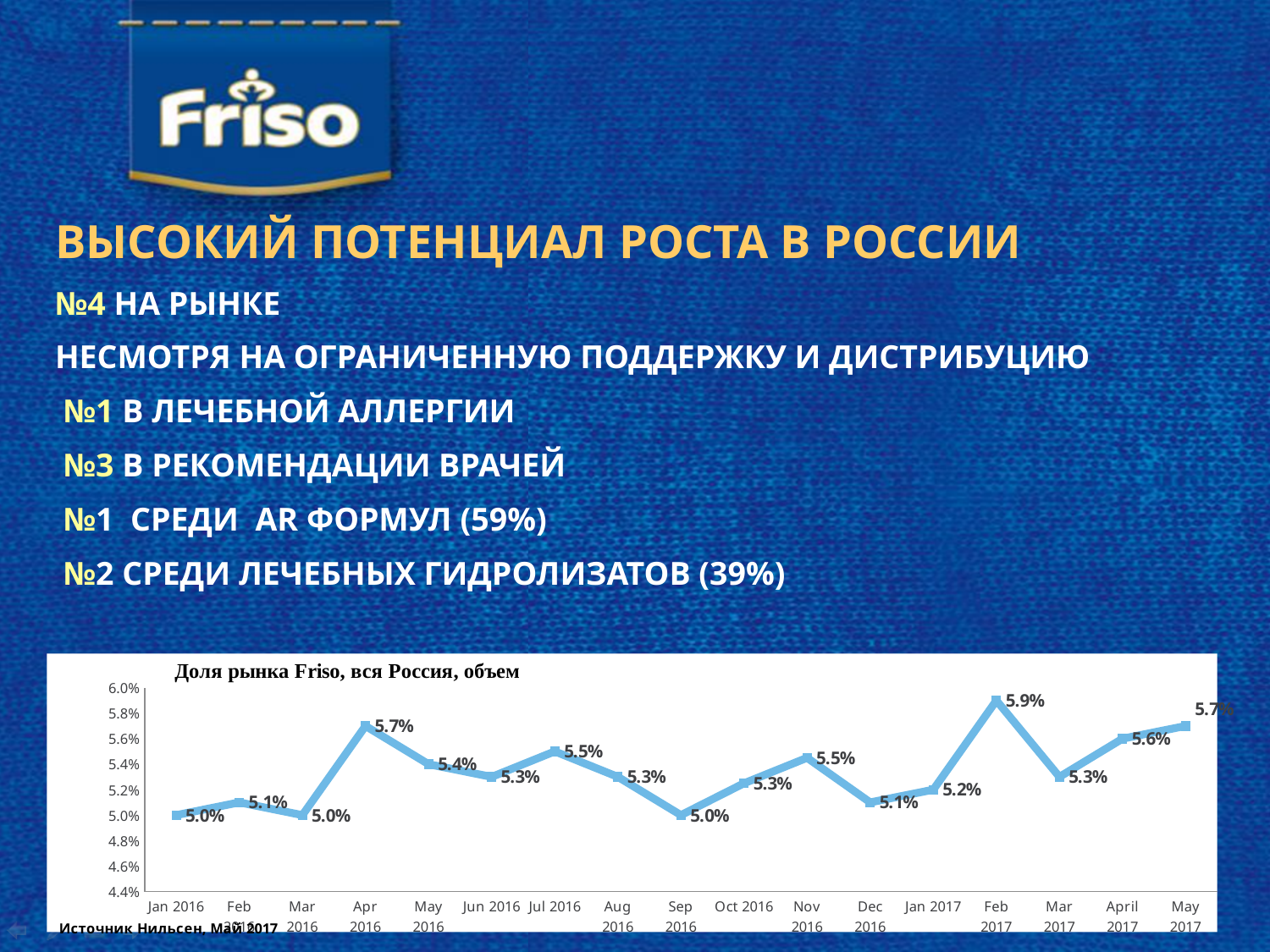
What is the title of the chart on the slide? Доля рынка Friso, вся Россия, объем What is the Friso market share value for Feb 2017? 5.9% What is the Friso market share value for May 2017? 5.7% How many monthly data points are plotted on the chart? 17 Which is larger, the market share in Apr 2016 or in May 2016? Apr 2016 What type of chart is shown on the slide? Line chart What is the Friso market share value for Sep 2016? 5.0% What is the difference between the market share in Feb 2017 and Jan 2017? 0.7% Does the Friso market share overall rise or fall from Jan 2016 to May 2017? Rise Which month has the highest Friso market share on the chart? Feb 2017 What is the Friso market share value for Apr 2016? 5.7% Is the market share value for Sep 2016 greater or less than 5.2%? less